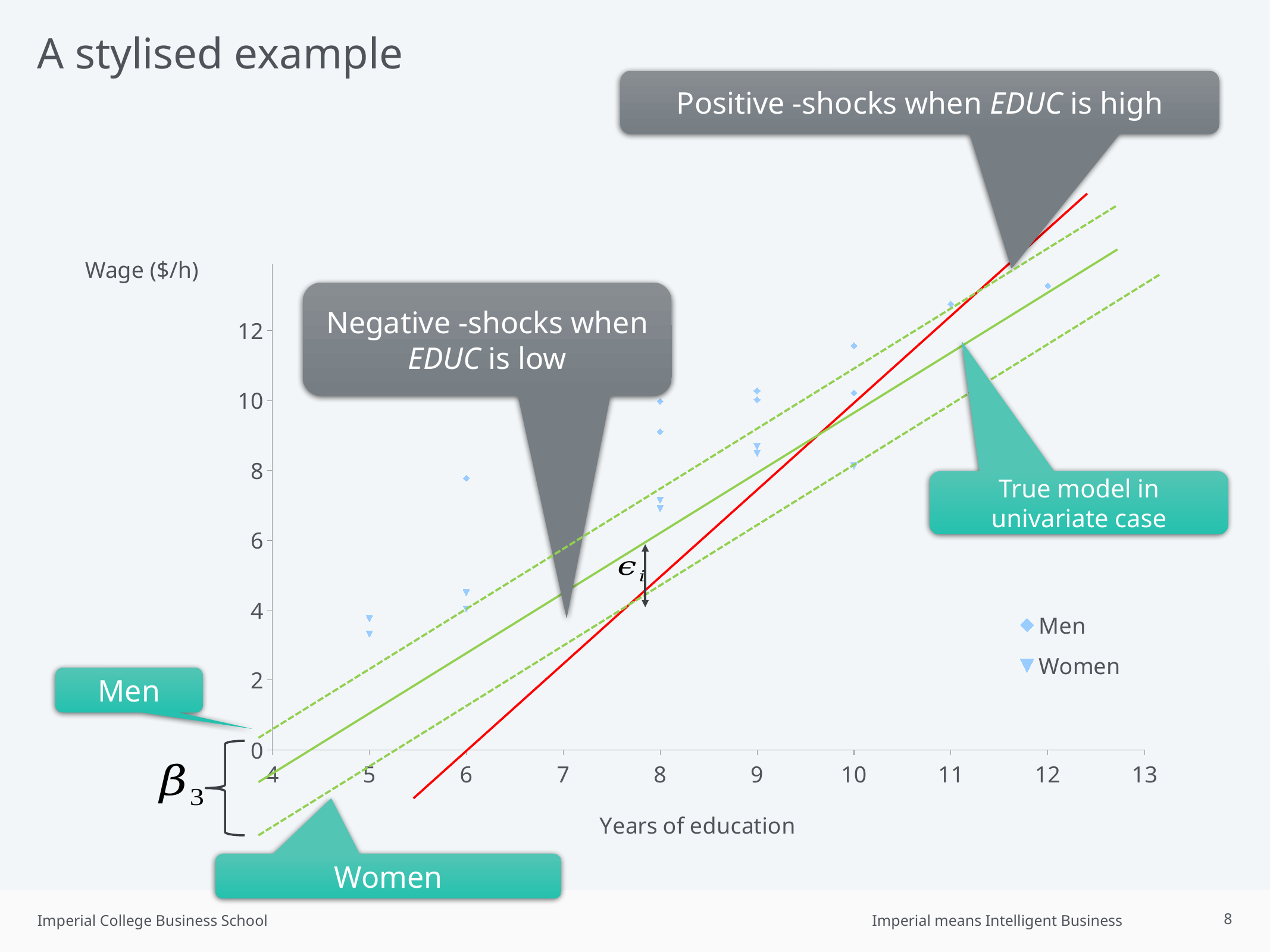
What kind of chart is shown on the slide? scatter chart How many series does the chart legend list? 2 Are the Men values at 10 years of education greater or less than 8? greater Is the Men value at 12 years of education greater or less than 12? greater Which series contains the highest plotted point on the chart? Men At which number of years of education is the lowest plotted point found? 5 Do wages generally rise or fall as years of education increase along the x axis? rise Is the Men value at 11 years of education greater or less than 12? greater What are the two series named in the chart legend? Men and Women What is the label of the horizontal axis of the chart? Years of education